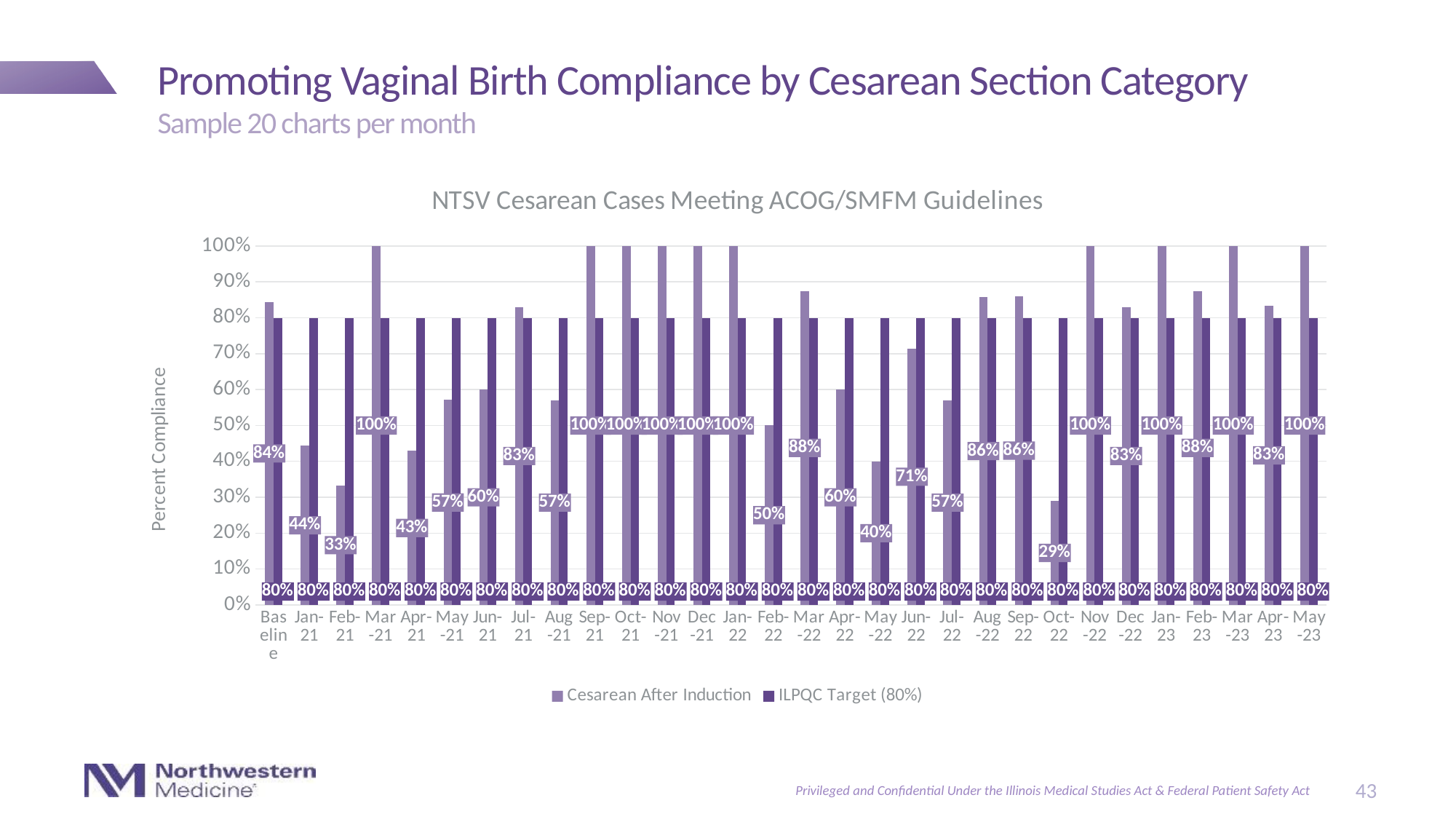
Is the Cesarean After Induction value for Apr-21 greater or less than the ILPQC Target of 80%? less What is the difference between the Cesarean After Induction values for Mar-22 and Feb-22? 38% What is the ILPQC Target value shown for Mar-22? 80% What is the title of the chart? NTSV Cesarean Cases Meeting ACOG/SMFM Guidelines Which is larger, the Cesarean After Induction value for Jan-21 or for Feb-21? Jan-21 How many series does the legend list? 2 What is the Cesarean After Induction value for Jun-22? 71% How many periods (categories) are shown on the x axis? 30 What is the Cesarean After Induction value for the Baseline period? 84% Which month has the lowest Cesarean After Induction value? Oct-22 What kind of chart is shown on the slide? Bar chart What is the Cesarean After Induction value for Oct-22? 29%